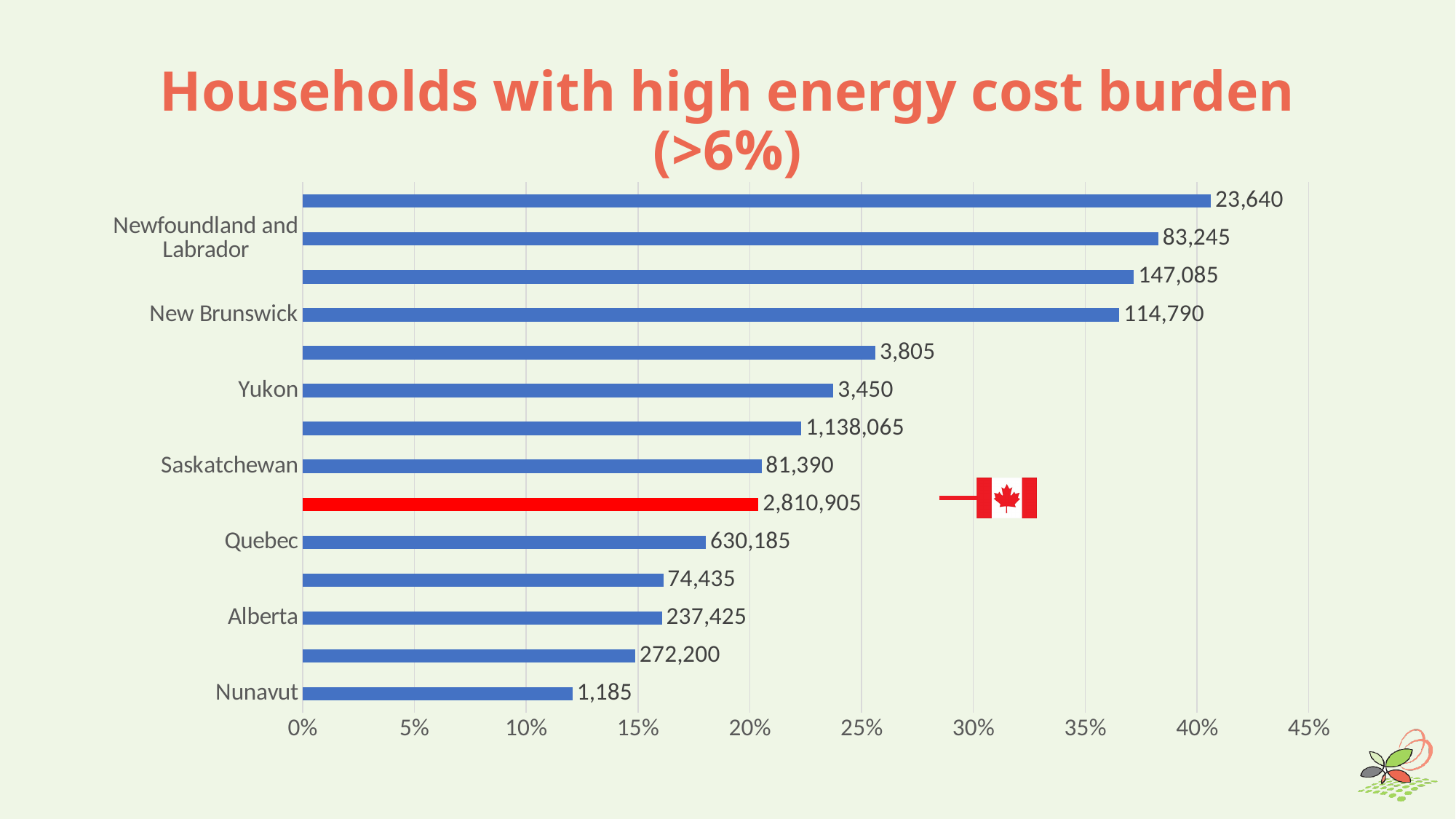
Which labelled category has the shortest bar? Nunavut What data label is shown next to the bar for Nunavut? 1,185 What data label is shown next to the bar for Quebec? 630,185 What type of chart is shown on the slide? bar chart What data label is shown next to the bar for Alberta? 237,425 What data label is shown next to the bar for Newfoundland and Labrador? 83,245 Is the bar for Nunavut greater or less than 15%? less What is the title of the chart? Households with high energy cost burden (>6%) What data label is shown next to the bar for Yukon? 3,450 What data label is shown on the red bar? 2,810,905 What data label is shown next to the bar for New Brunswick? 114,790 What data label is shown next to the bar for Saskatchewan? 81,390